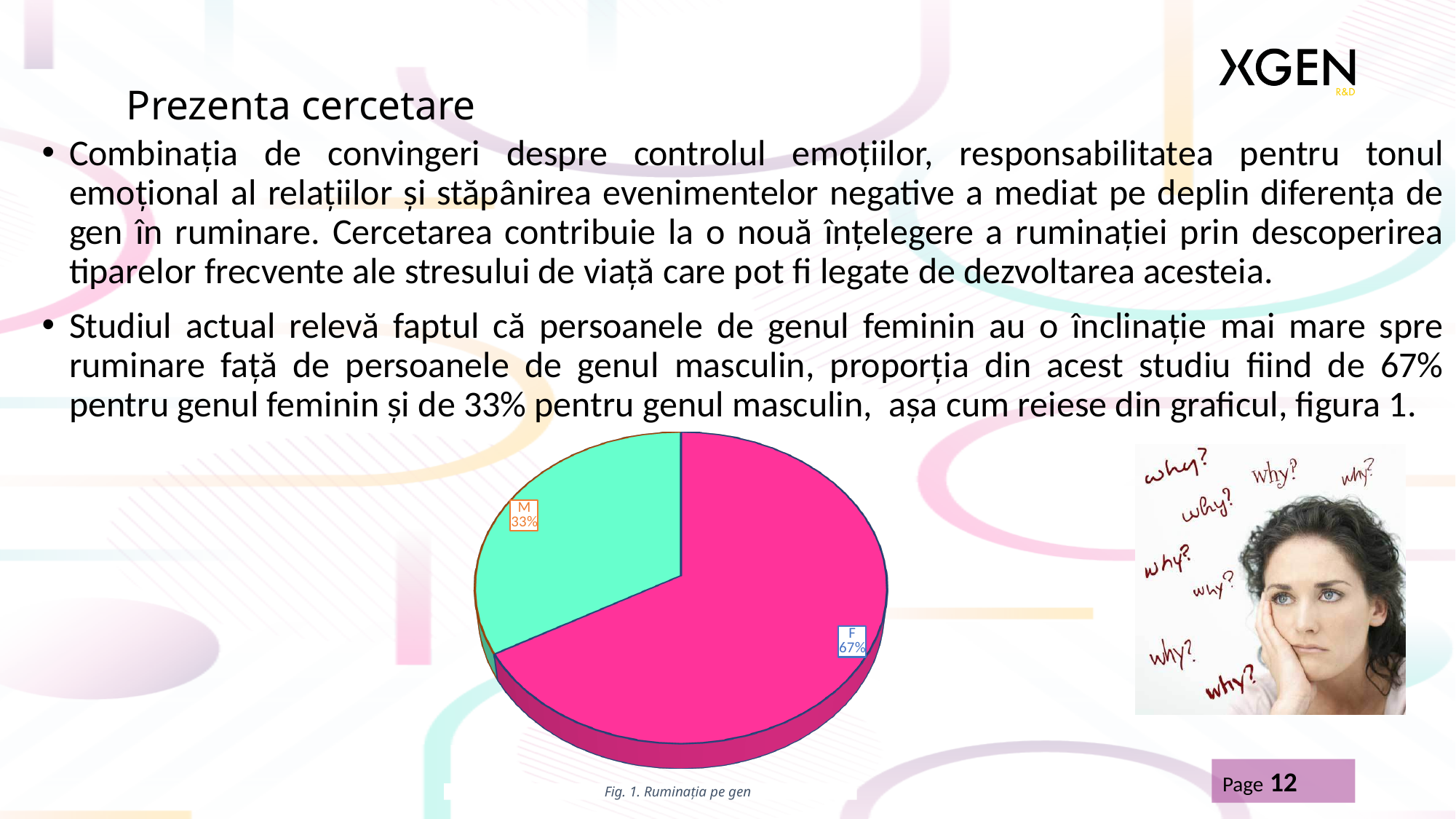
How many slices does the pie chart have? 2 What colour is the F slice of the pie chart? pink Is the share for M greater or less than 50%? less What share of the pie does the M slice represent? 33% What kind of chart is shown on the slide? pie chart Which slice of the pie is the largest? F Which is larger, the F slice or the M slice? F Which slice of the pie is the smallest? M What share of the pie does the F slice represent? 67% What is the difference in percentage points between the F slice and the M slice? 34 What is the caption of the figure below the pie chart? Fig. 1. Ruminația pe gen